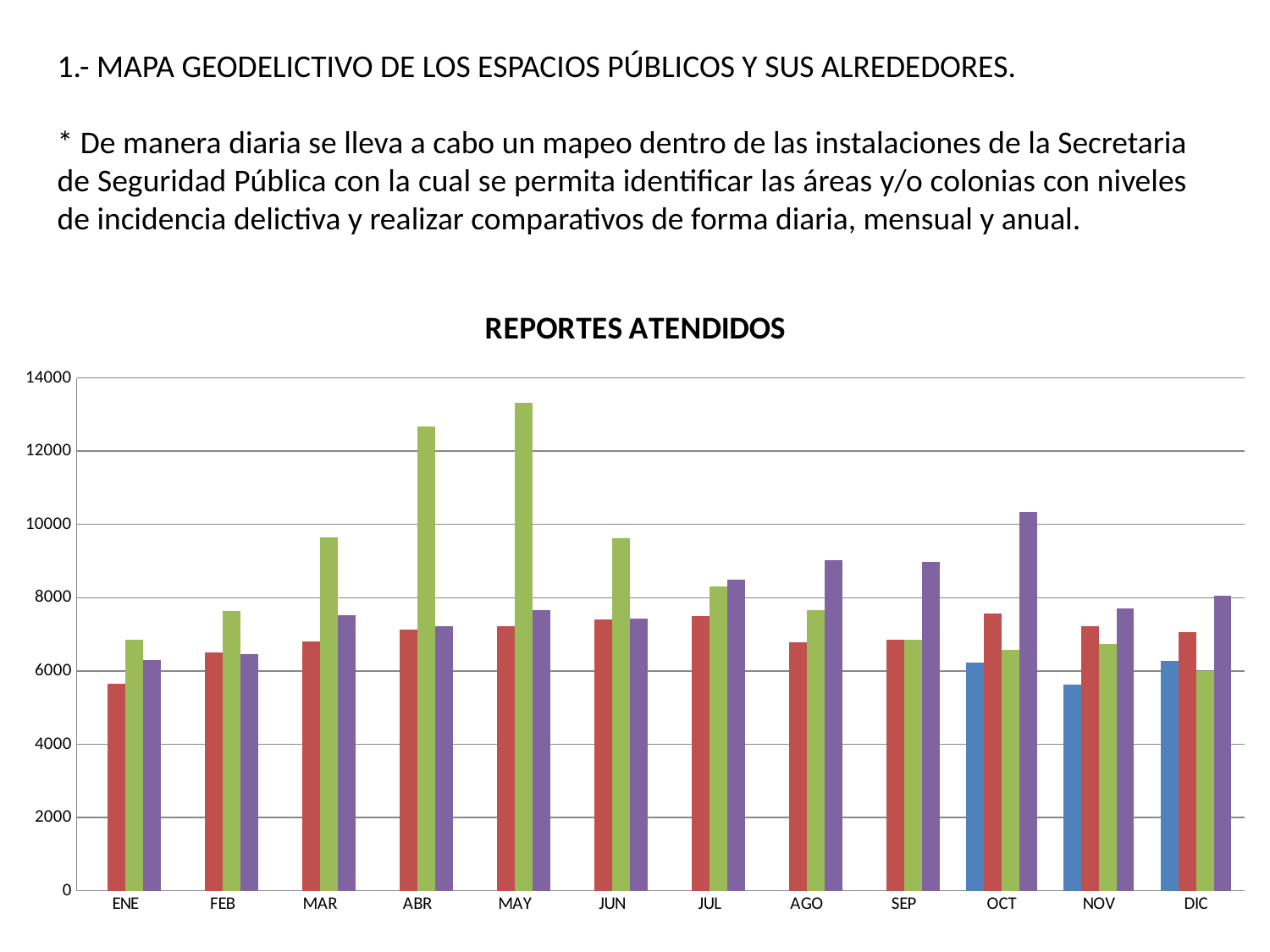
Is the value of the green bar for ABR greater or less than 12000? greater Which month has the tallest green bar in the REPORTES ATENDIDOS chart? MAY How many months are shown on the x axis of the REPORTES ATENDIDOS chart? 12 What kind of chart is shown under the title REPORTES ATENDIDOS? bar chart In OCT, which is larger, the blue bar or the purple bar? the purple bar Is the value of the green bar for MAY greater or less than 12000? greater Which month has the tallest purple bar in the REPORTES ATENDIDOS chart? OCT What is the title of the chart on the slide? REPORTES ATENDIDOS Is the value of the blue bar for NOV greater or less than 6000? less In ABR, which is larger, the green bar or the purple bar? the green bar In how many months does a blue bar appear in the REPORTES ATENDIDOS chart? 3